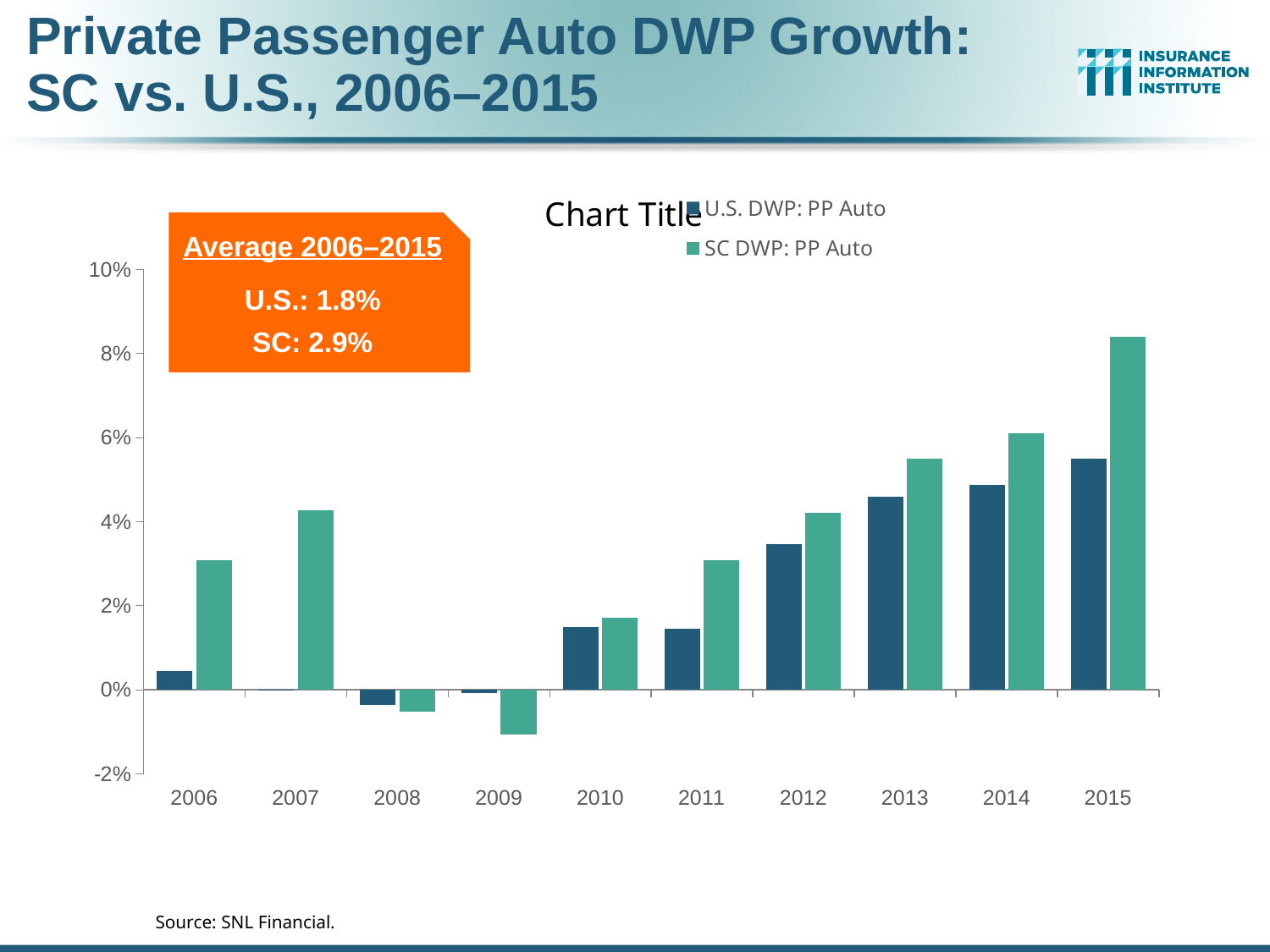
Is the U.S. DWP: PP Auto value for 2012 greater or less than 4%? less In which year is U.S. DWP: PP Auto growth highest? 2015 Is the SC DWP: PP Auto value for 2015 greater or less than 8%? greater What kind of chart is shown on the slide? bar chart According to the text box, what is the SC average DWP growth for 2006–2015? 2.9% Do the U.S. DWP: PP Auto values rise or fall from 2011 to 2015? rise Is the SC DWP: PP Auto value for 2013 greater or less than 6%? less How many series does the legend list? 2 In 2012, which series has the larger value, U.S. DWP: PP Auto or SC DWP: PP Auto? SC DWP: PP Auto In which year is SC DWP: PP Auto growth highest? 2015 In which year is SC DWP: PP Auto growth lowest? 2009 How many years are shown on the x axis? 10